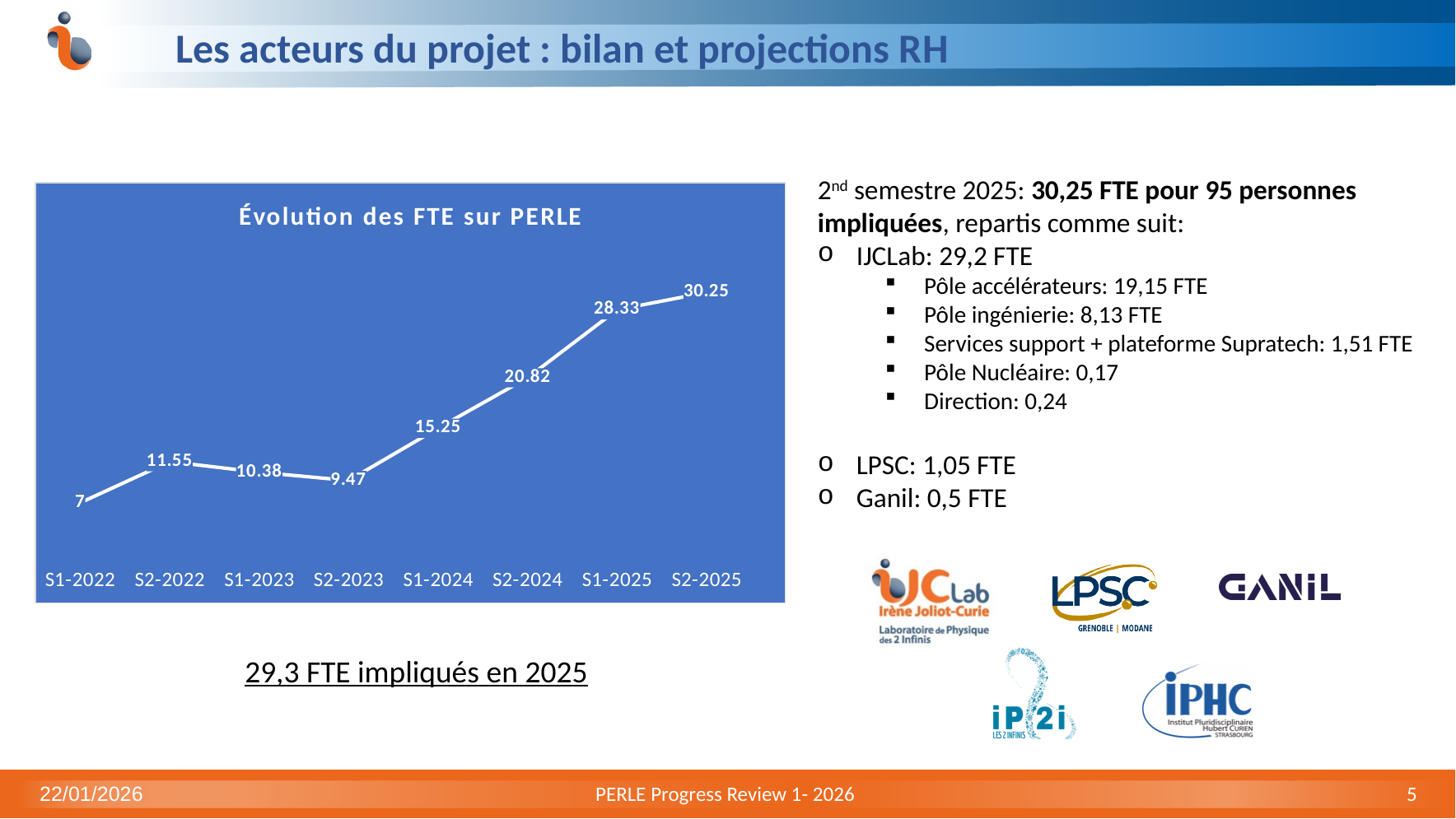
What is the FTE value for S2-2025? 30.25 What is the difference between the FTE values for S2-2025 and S1-2025? 1.92 What kind of chart is shown on the slide? line chart Do the FTE values generally rise or fall from S2-2023 to S2-2025? rise Which semester has the highest FTE value? S2-2025 Which is larger, the FTE value for S2-2022 or for S1-2023? S2-2022 What is the FTE value for S2-2023? 9.47 How many data points are plotted on the chart? 8 What is the title of the chart? Évolution des FTE sur PERLE What is the FTE value for S1-2022? 7 Which semester has the lowest FTE value? S1-2022 What is the FTE value for S1-2024? 15.25